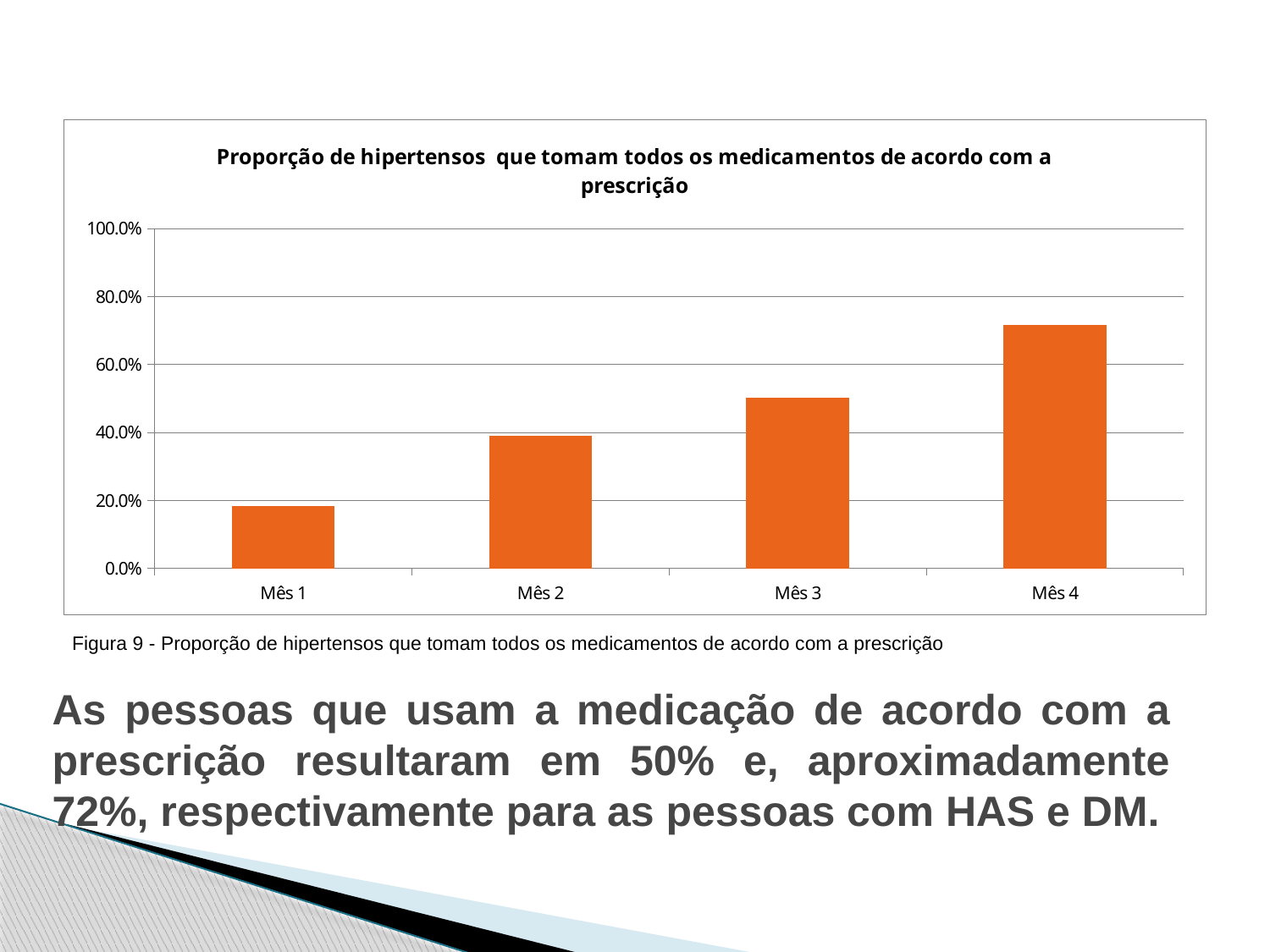
How many months (categories) are plotted on the x axis? 4 Is the value for Mês 4 greater or less than 60.0%? greater Which is larger, the value for Mês 3 or the value for Mês 2? Mês 3 Is the value for Mês 1 greater or less than 20.0%? less Is the value for Mês 4 greater or less than 80.0%? less Which month has the highest proportion of hypertensive patients taking all medications as prescribed? Mês 4 What is the title of the chart? Proporção de hipertensos que tomam todos os medicamentos de acordo com a prescrição Which month has the lowest proportion? Mês 1 What kind of chart is shown on the slide? bar chart Do the values rise or fall from Mês 1 to Mês 4? rise